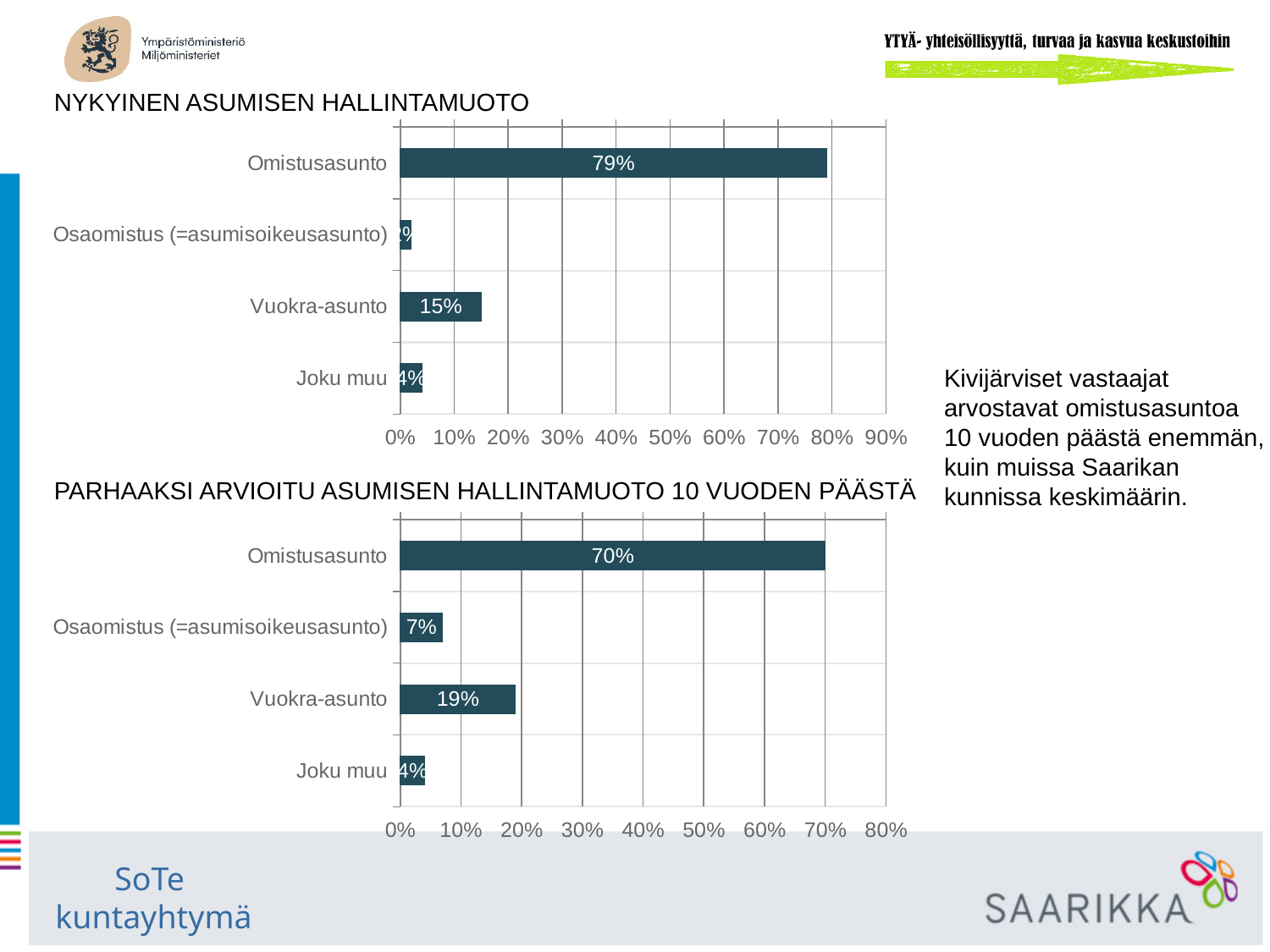
In the top chart (NYKYINEN ASUMISEN HALLINTAMUOTO), what is the value for Vuokra-asunto? 15% In the top chart (NYKYINEN ASUMISEN HALLINTAMUOTO), what is the difference between Omistusasunto and Vuokra-asunto? 64% In the bottom chart (PARHAAKSI ARVIOITU ASUMISEN HALLINTAMUOTO 10 VUODEN PÄÄSTÄ), which category has the lowest value? Joku muu What type of chart is the top chart (NYKYINEN ASUMISEN HALLINTAMUOTO)? Bar chart In the top chart (NYKYINEN ASUMISEN HALLINTAMUOTO), what is the value for Omistusasunto? 79% In the bottom chart (PARHAAKSI ARVIOITU ASUMISEN HALLINTAMUOTO 10 VUODEN PÄÄSTÄ), what is the value for Omistusasunto? 70% In the bottom chart (PARHAAKSI ARVIOITU ASUMISEN HALLINTAMUOTO 10 VUODEN PÄÄSTÄ), what is the value for Osaomistus (=asumisoikeusasunto)? 7% In the bottom chart (PARHAAKSI ARVIOITU ASUMISEN HALLINTAMUOTO 10 VUODEN PÄÄSTÄ), what is the difference between Vuokra-asunto and Joku muu? 15% In the bottom chart (PARHAAKSI ARVIOITU ASUMISEN HALLINTAMUOTO 10 VUODEN PÄÄSTÄ), which is larger, Vuokra-asunto or Osaomistus (=asumisoikeusasunto)? Vuokra-asunto In the top chart (NYKYINEN ASUMISEN HALLINTAMUOTO), is the value for Osaomistus (=asumisoikeusasunto) greater or less than 10%? less How many categories does the bottom chart (PARHAAKSI ARVIOITU ASUMISEN HALLINTAMUOTO 10 VUODEN PÄÄSTÄ) show? 4 In the top chart (NYKYINEN ASUMISEN HALLINTAMUOTO), which category has the highest value? Omistusasunto